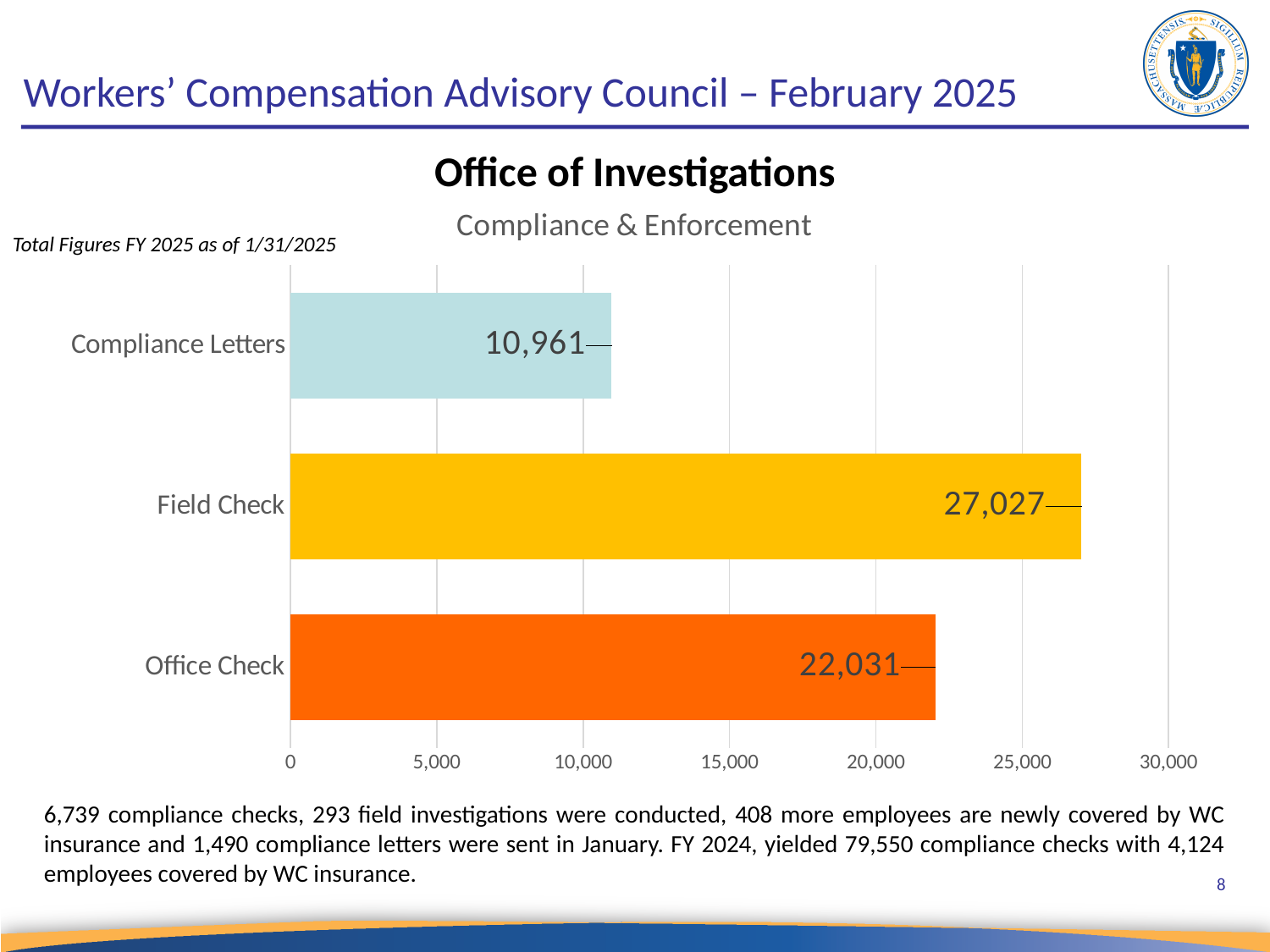
How many categories are shown in the chart? 3 What is the title of the chart? Compliance & Enforcement What is the value for Field Check? 27,027 Is the value for Field Check greater or less than 25,000? greater What kind of chart is shown on the slide? Bar chart What is the difference between the Field Check and Office Check values? 4,996 What is the value for Compliance Letters? 10,961 Which is larger, Office Check or Compliance Letters? Office Check What is the value for Office Check? 22,031 Which category has the lowest value? Compliance Letters Which category has the highest value? Field Check What is the difference between the Office Check and Compliance Letters values? 11,070